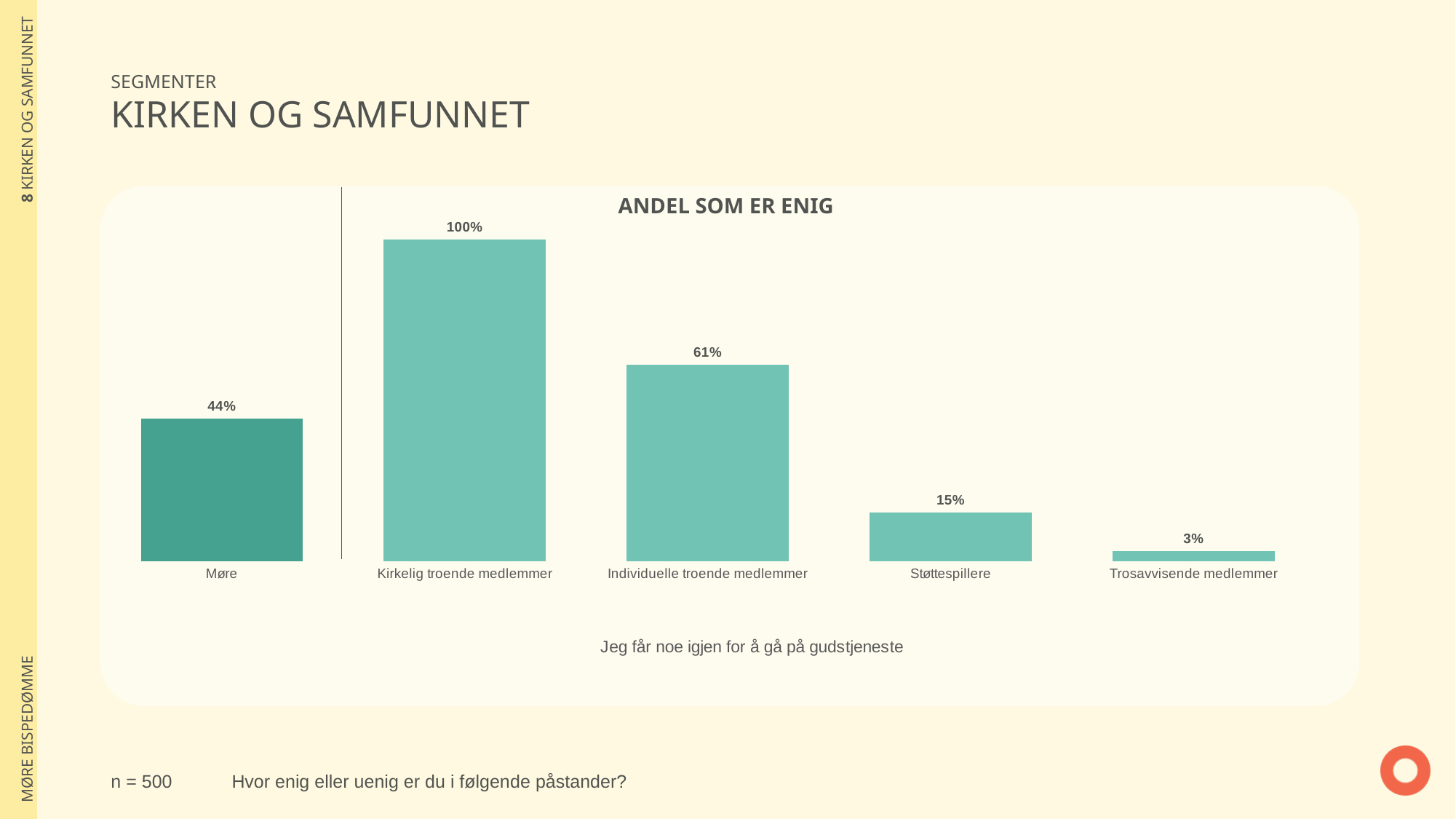
What kind of chart is shown on the slide? Bar chart Which category has the lowest value? Trosavvisende medlemmer What is the value for Kirkelig troende medlemmer? 100% What is the value for Støttespillere? 15% What is the value for Trosavvisende medlemmer? 3% What is the title of the chart? ANDEL SOM ER ENIG What is the difference between the values for Kirkelig troende medlemmer and Individuelle troende medlemmer? 39% Which is larger, the value for Møre or the value for Støttespillere? Møre What is the value for Møre? 44% How many categories are shown in the chart? 5 Which category has the highest value? Kirkelig troende medlemmer What is the value for Individuelle troende medlemmer? 61%